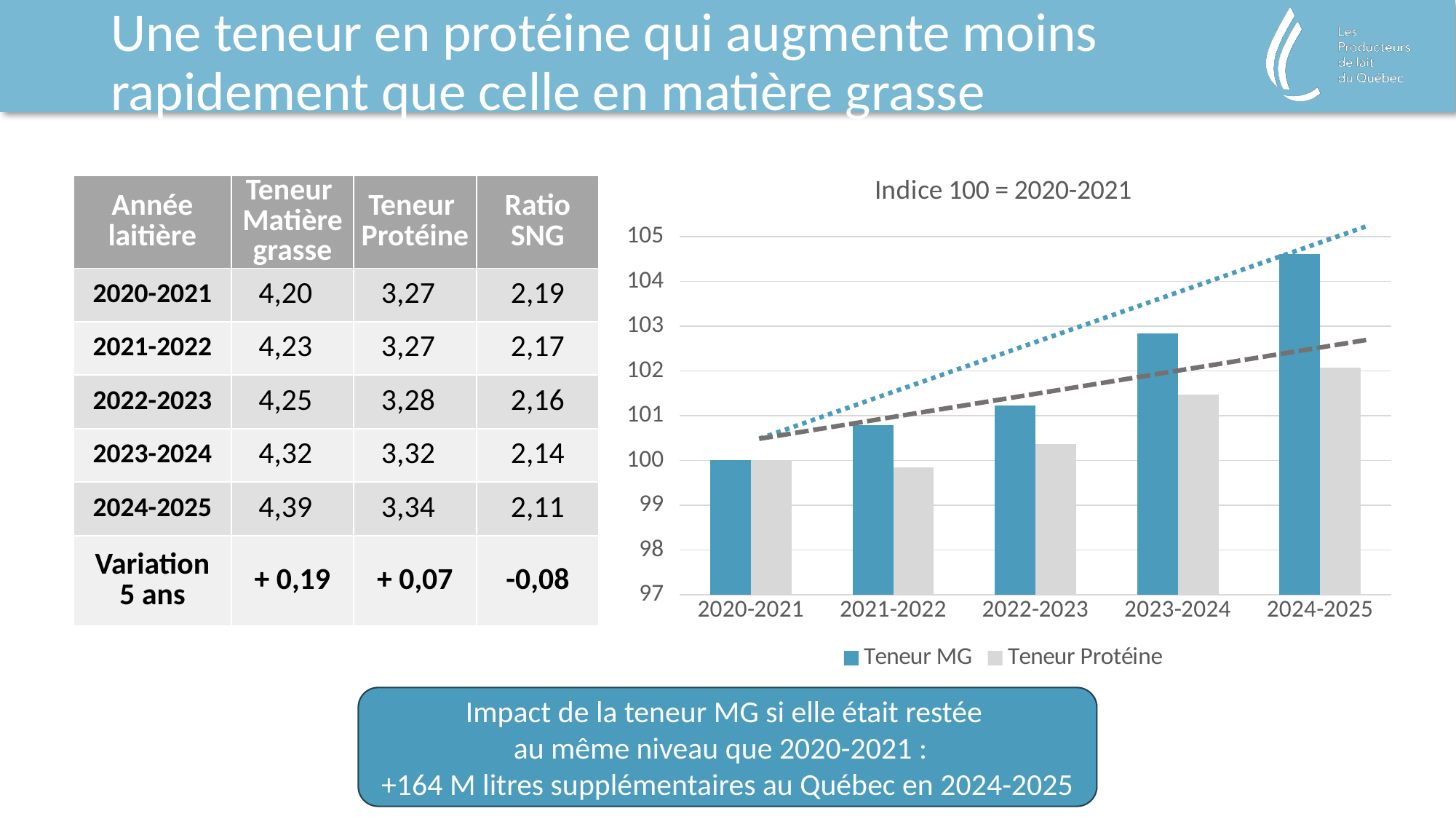
How many dairy years are shown on the x axis of the chart? 5 What is the title of the chart? Indice 100 = 2020-2021 Is the Teneur MG value for 2021-2022 greater or less than 101? less What is the index value of Teneur MG for 2020-2021 in the chart? 100 Is the Teneur Protéine value for 2024-2025 greater or less than 103? less How many series does the chart legend list? 2 In which year is the Teneur MG bar highest in the chart? 2024-2025 Is the Teneur MG value for 2024-2025 greater or less than 104? greater Do the Teneur MG values rise or fall from 2020-2021 to 2024-2025 in the chart? rise What kind of chart is shown on the slide? bar chart For 2024-2025, which is larger in the chart: Teneur MG or Teneur Protéine? Teneur MG